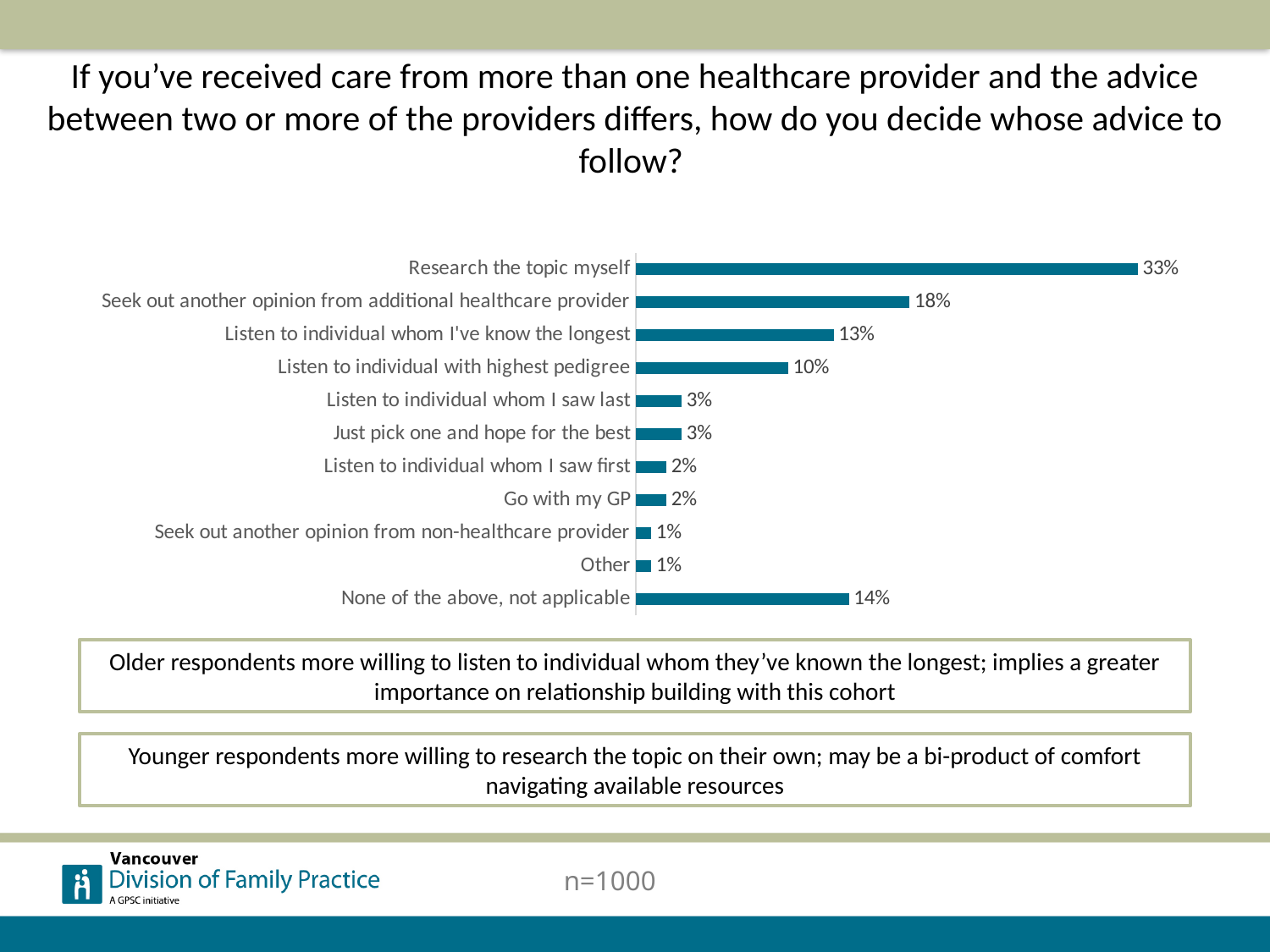
Which category has the highest value? Research the topic myself What kind of chart is shown on the slide? Bar chart What is the value for "None of the above, not applicable"? 14% What sample size is shown on the slide? n=1000 What is the difference between "Research the topic myself" and "Seek out another opinion from additional healthcare provider"? 15% How many categories are shown in the chart? 11 What percentage of respondents said they research the topic myself? 33% What is the value for "Seek out another opinion from additional healthcare provider"? 18% Which is larger: "Listen to individual with highest pedigree" or "Listen to individual whom I saw last"? Listen to individual with highest pedigree What is the difference between "Listen to individual whom I've know the longest" and "Listen to individual with highest pedigree"? 3% What is the value for "Go with my GP"? 2% Which is larger: "None of the above, not applicable" or "Listen to individual whom I've know the longest"? None of the above, not applicable